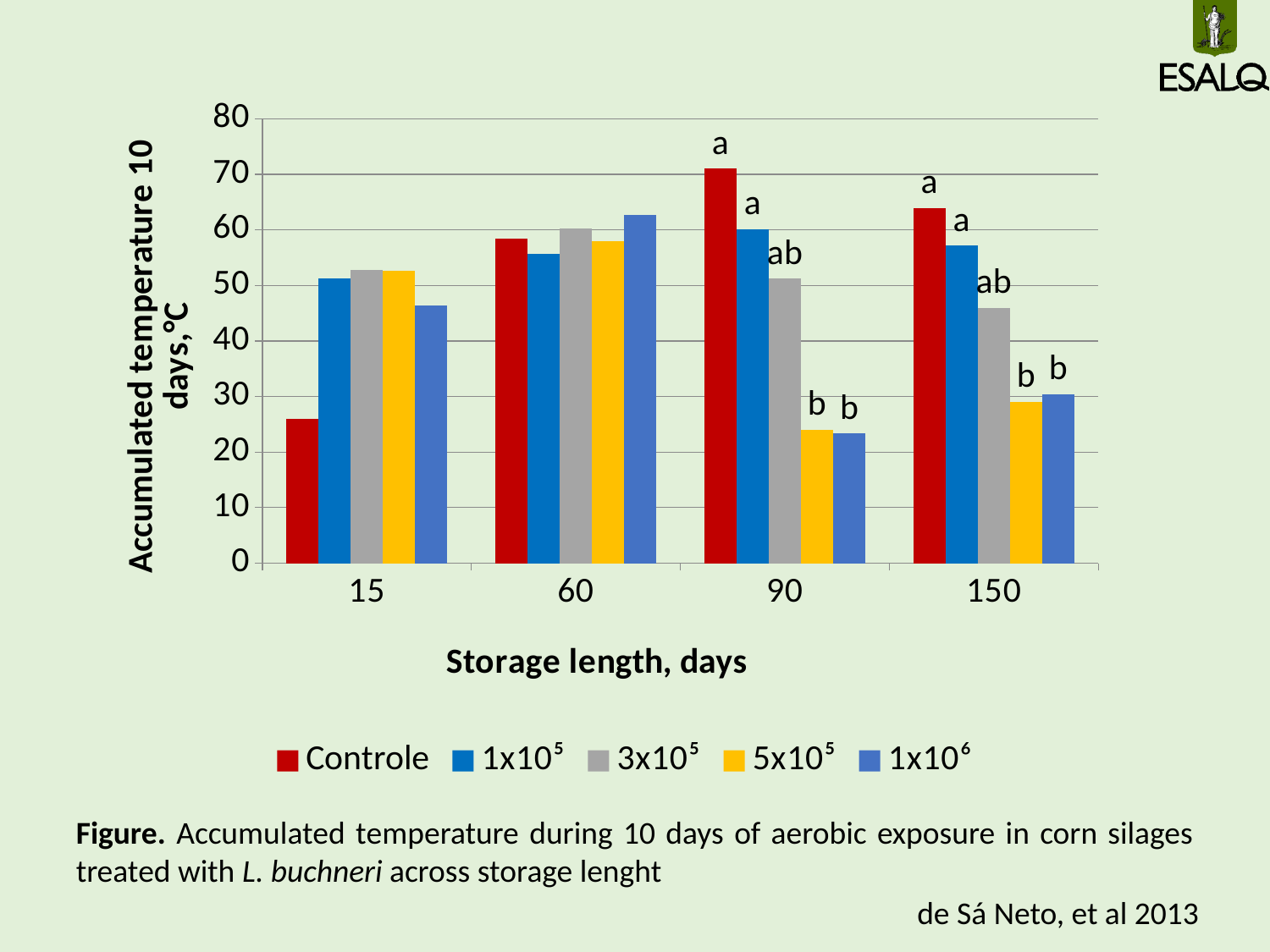
At 90 days, which is larger: the Controle value or the 5x10⁵ value? Controle Is the Controle value at 90 days greater or less than 60? greater At which storage length is the Controle bar lowest? 15 Is the Controle value at 15 days greater or less than 30? less How many storage lengths are shown on the x axis? 4 What kind of chart is shown on the slide? bar chart Does the Controle value rise or fall from 15 days to 90 days? rise At 15 days, which is larger: the Controle value or the 1x10⁵ value? 1x10⁵ At which storage length is the Controle bar highest? 90 Is the 5x10⁵ value at 90 days greater or less than 30? less What is the title of the x axis? Storage length, days How many series does the legend list? 5